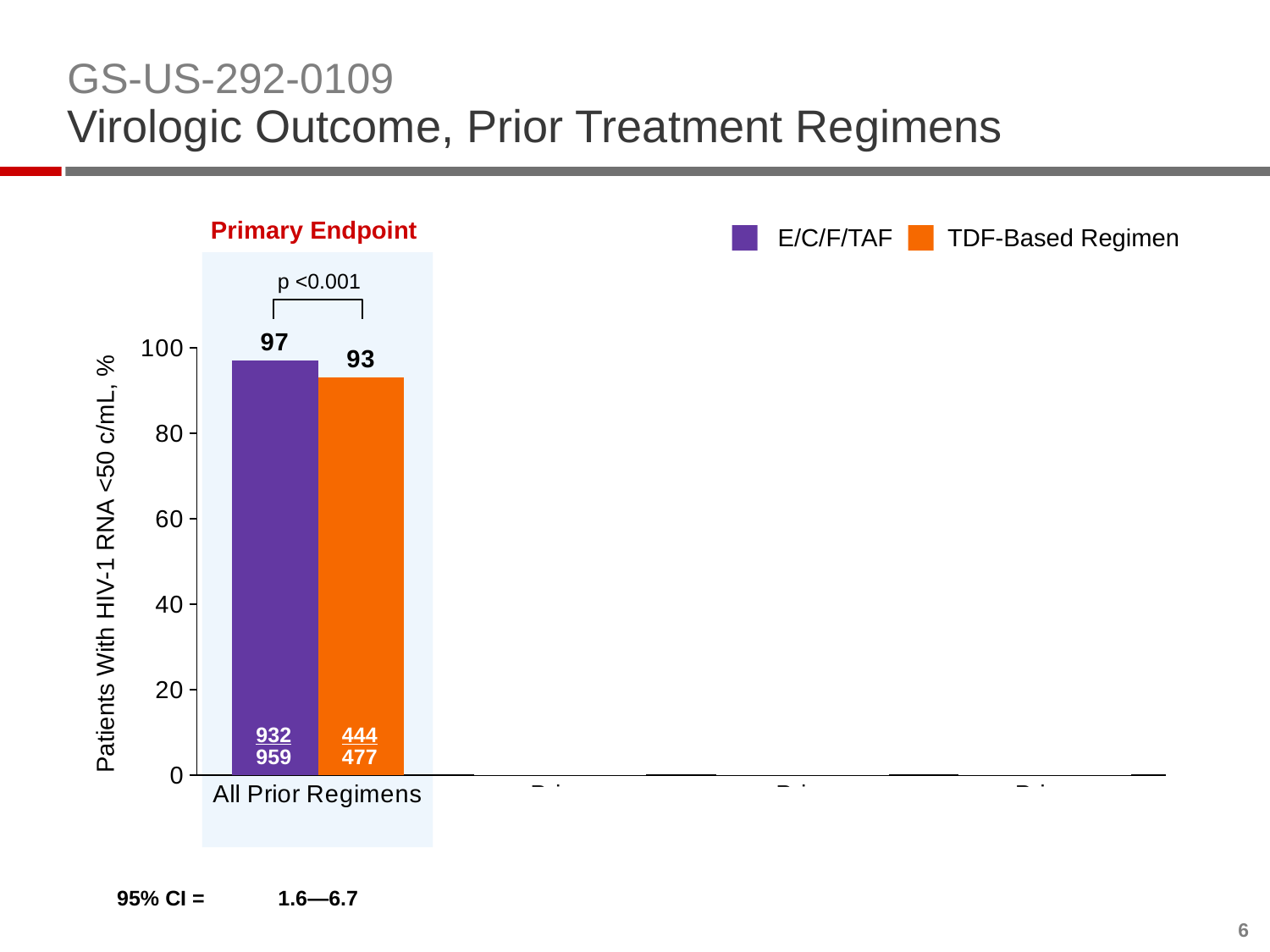
What p-value is shown above the All Prior Regimens bars? p <0.001 What is the value for TDF-Based Regimen in the All Prior Regimens category? 93 What is the label of the y axis? Patients With HIV-1 RNA <50 c/mL, % What 95% CI is printed below the chart? 1.6—6.7 Is the value for TDF-Based Regimen in All Prior Regimens greater or less than 80? greater How many series does the legend list? 2 What fraction is printed inside the E/C/F/TAF bar for All Prior Regimens? 932/959 What kind of chart is shown on the slide? bar chart Which series has the higher value for All Prior Regimens, E/C/F/TAF or TDF-Based Regimen? E/C/F/TAF What fraction is printed inside the TDF-Based Regimen bar for All Prior Regimens? 444/477 What is the difference between the E/C/F/TAF and TDF-Based Regimen values for All Prior Regimens? 4 What is the value for E/C/F/TAF in the All Prior Regimens category? 97